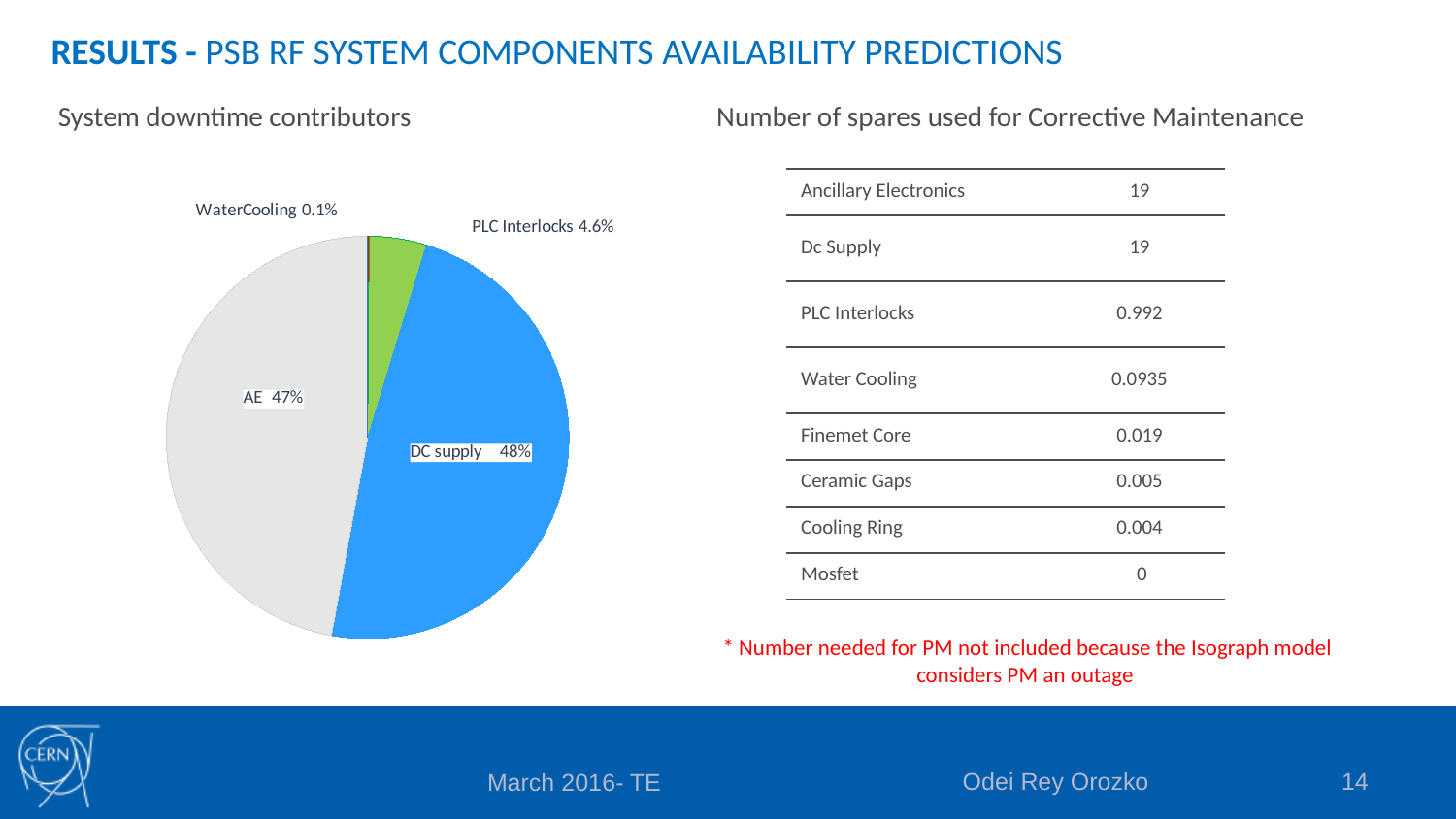
How many slices does the system downtime contributors pie chart have? 4 What share of system downtime is attributed to WaterCooling? 0.1% What share of system downtime is attributed to AE? 47% What is the combined share of AE and DC supply in the system downtime pie chart? 95% Which is larger in the pie chart, the PLC Interlocks share or the WaterCooling share? PLC Interlocks What kind of chart is shown under "System downtime contributors"? pie chart Which contributor has the largest slice of the system downtime pie chart? DC supply What colour is the PLC Interlocks slice in the pie chart? green What share of system downtime is attributed to DC supply? 48% What is the difference between the DC supply share and the PLC Interlocks share in the pie chart? 43.4% What share of system downtime is attributed to PLC Interlocks? 4.6%